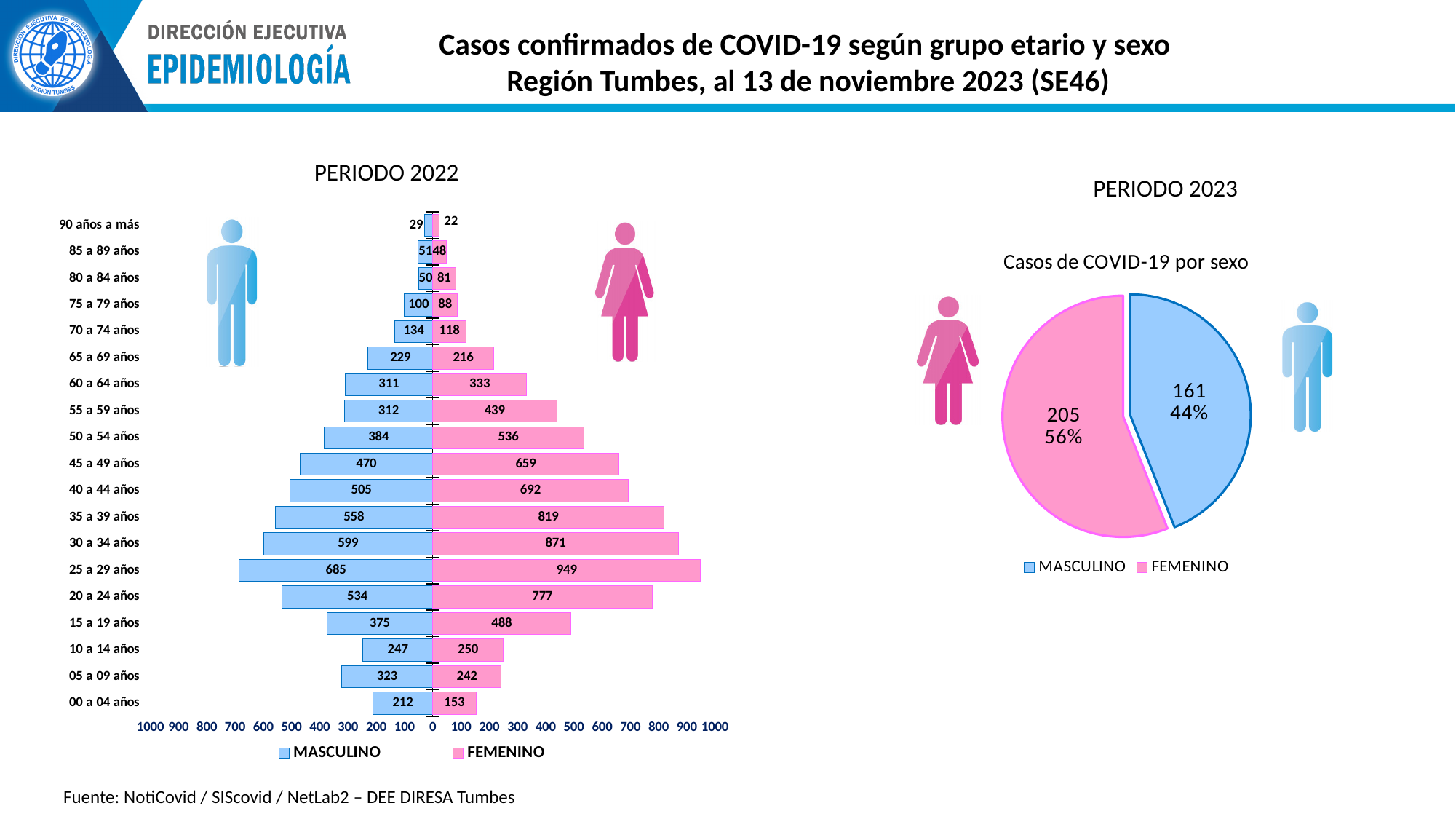
In the PERIODO 2022 chart, what is the difference between the FEMENINO and MASCULINO values for the 45 a 49 años group? 189 In the PERIODO 2023 pie chart, what share of cases is FEMENINO? 56% In the PERIODO 2023 pie chart, how many MASCULINO cases are shown? 161 In the PERIODO 2022 chart, how many MASCULINO cases are shown for the 25 a 29 años group? 685 In the PERIODO 2023 pie chart, what is the total number of cases across both slices? 366 What kind of chart is the PERIODO 2022 chart? Bar chart In the PERIODO 2022 chart, how many age groups are listed? 19 In the PERIODO 2022 chart, how many FEMENINO cases are shown for the 30 a 34 años group? 871 In the PERIODO 2022 chart, which age group has the highest FEMENINO value? 25 a 29 años In the PERIODO 2022 chart, which age group has the lowest MASCULINO value? 90 años a más In the PERIODO 2022 chart, for the 05 a 09 años group, which is larger, MASCULINO or FEMENINO? MASCULINO How many series does the legend of the PERIODO 2022 chart list? 2